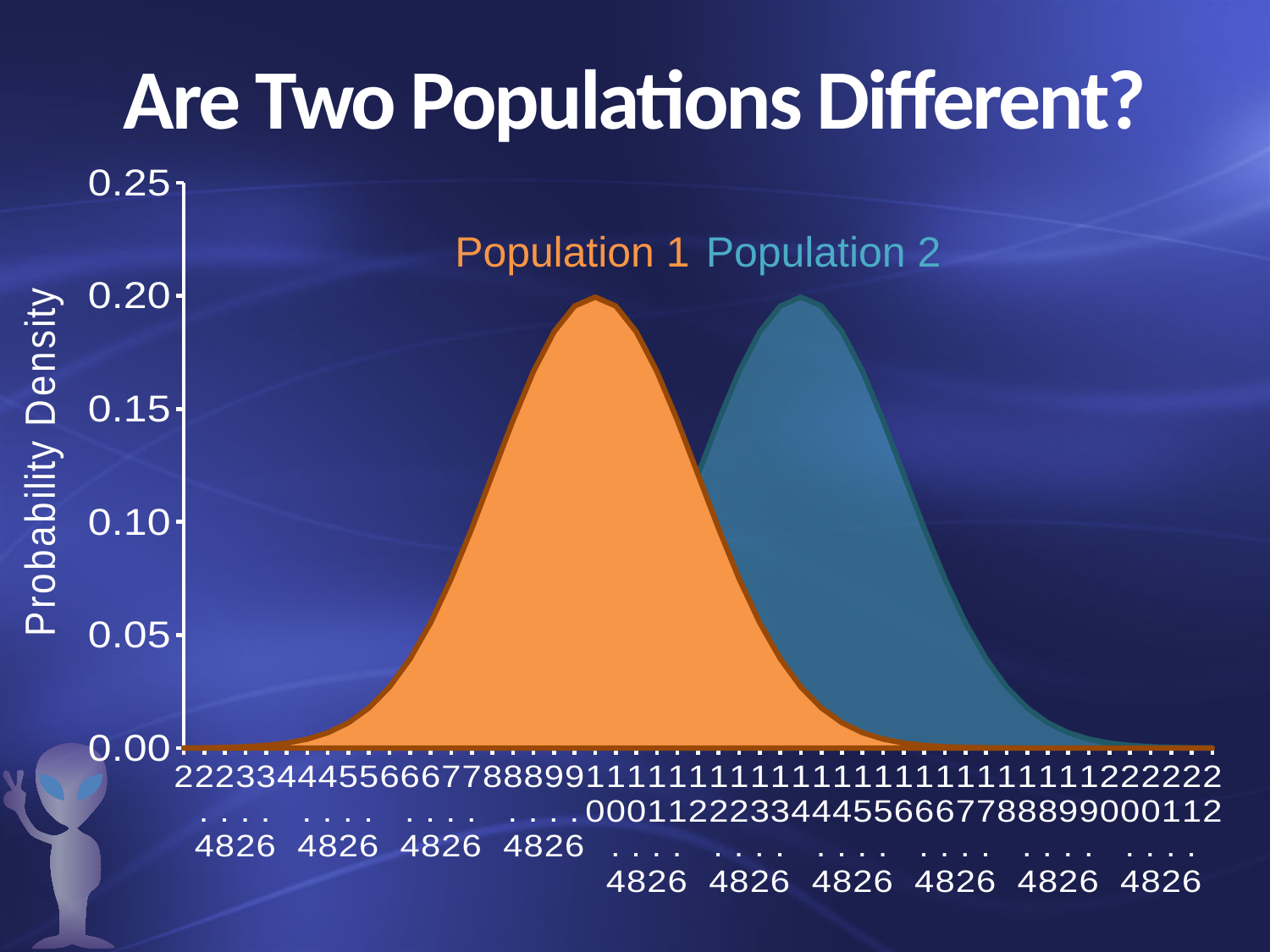
What is the highest value shown on the vertical axis? 0.25 Is the peak probability density of Population 1 greater or less than 0.15? greater What is the title of the slide's chart? Are Two Populations Different? Which population's curve peaks further to the left along the x axis? Population 1 What kind of chart is shown on the slide? area chart Is the peak probability density of Population 2 greater or less than 0.25? less What is the label on the vertical axis? Probability Density How many series (populations) are plotted on the chart? 2 Which population's curve peaks further to the right along the x axis? Population 2 Is the peak probability density of Population 2 greater or less than 0.10? greater Does the Population 1 curve rise or fall as the x axis moves from its peak toward the right end of the chart? fall